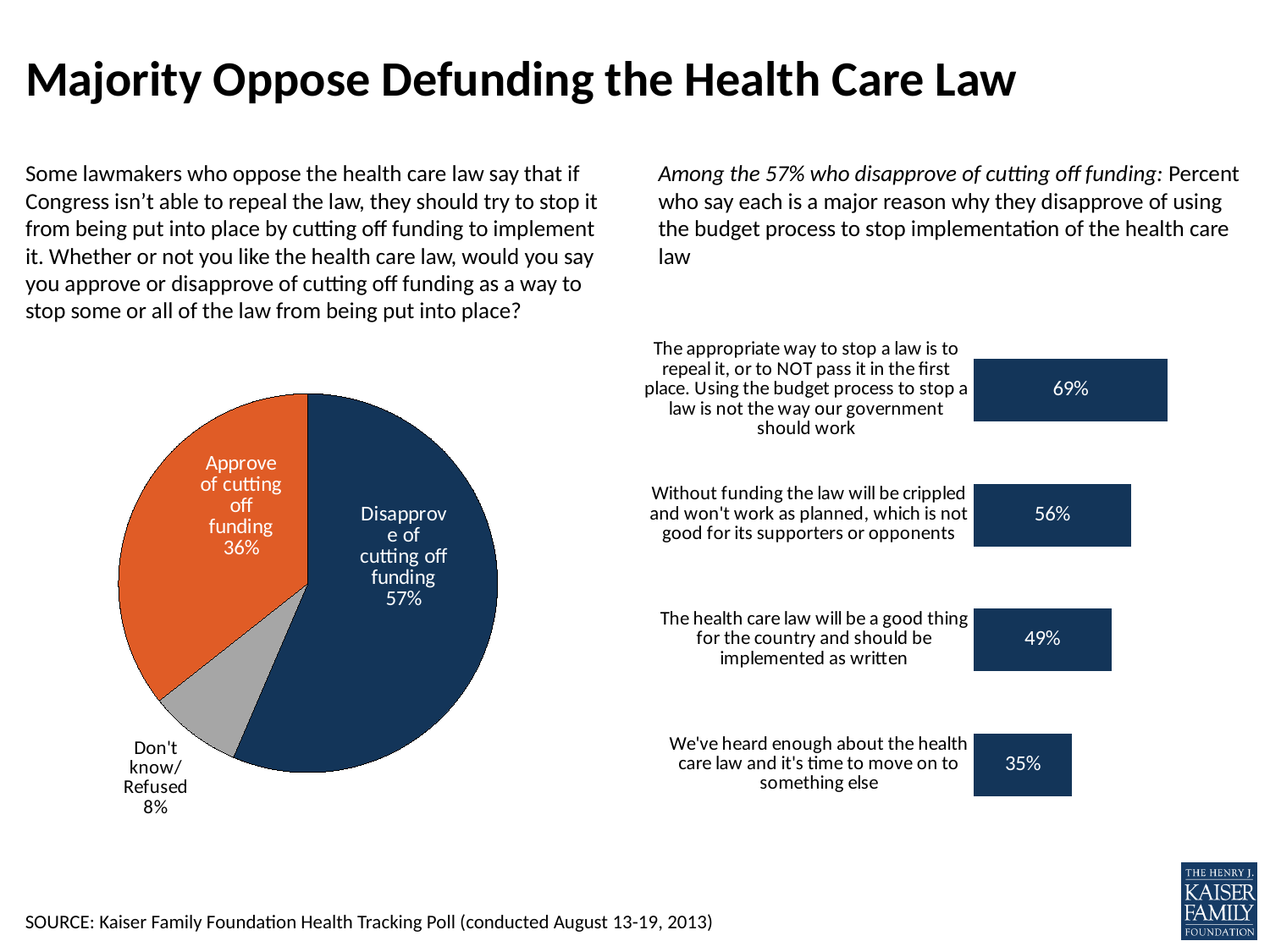
In the bar chart on the right, what is the difference between the highest bar (69%) and the lowest bar (35%)? 34 percentage points In the bar chart on the right, how many reasons are shown? 4 In the pie chart on the left, which slice is the largest? Disapprove of cutting off funding What kind of chart is on the right side of the slide? Bar chart In the pie chart on the left, what percent approve of cutting off funding? 36% In the bar chart on the right, which reason has the highest percentage? The appropriate way to stop a law is to repeal it, or to NOT pass it in the first place. Using the budget process to stop a law is not the way our government should work In the bar chart on the right, what percent say 'Without funding the law will be crippled and won't work as planned' is a major reason? 56% In the pie chart on the left, what percent disapprove of cutting off funding? 57% In the pie chart on the left, which slice is the smallest? Don't know/Refused What kind of chart is on the left side of the slide? Pie chart In the pie chart on the left, what is the share for Don't know/Refused? 8% In the pie chart on the left, how many slices are there? 3